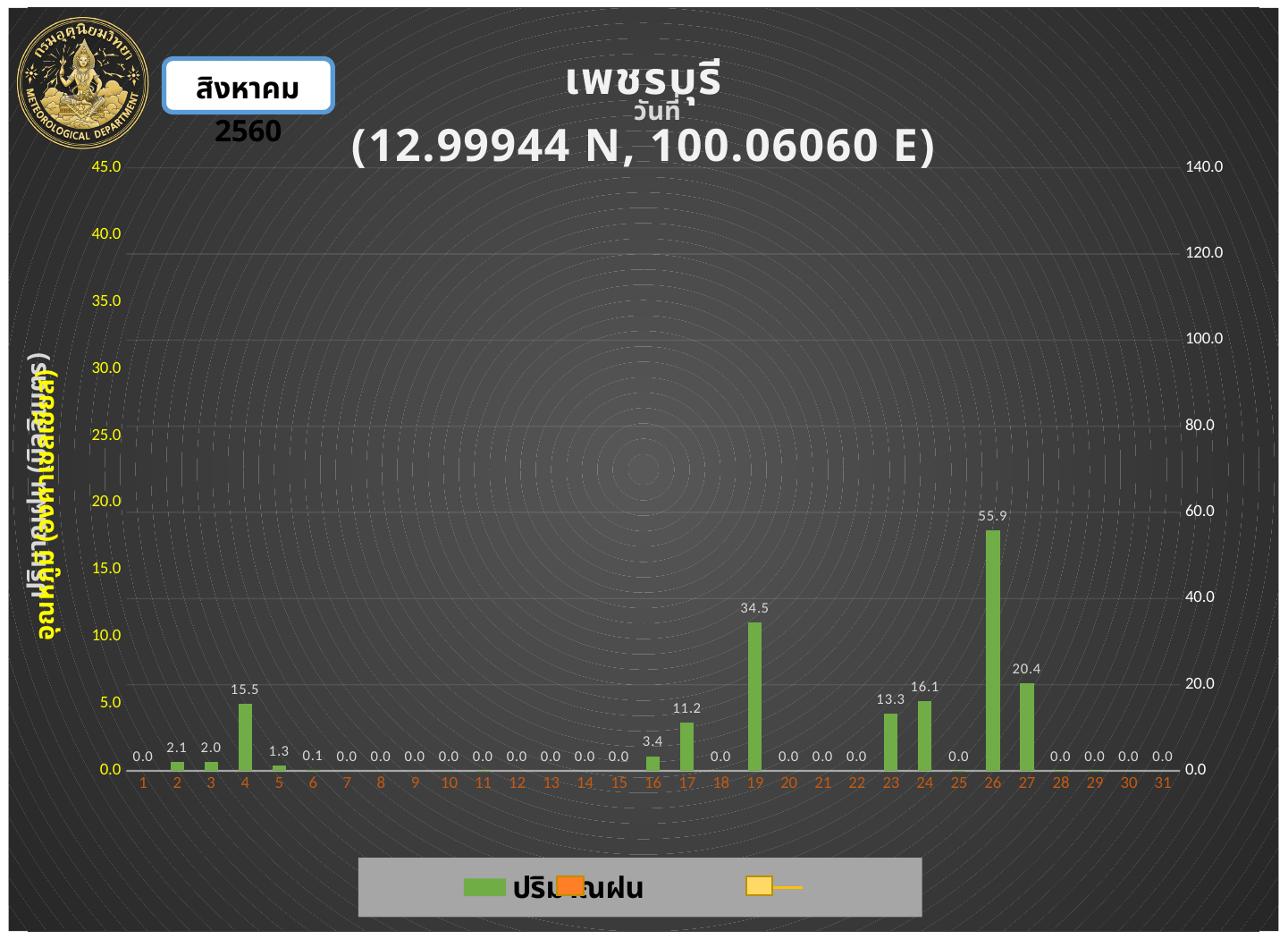
What is the rainfall value shown for day 4? 15.5 What is the rainfall value shown for day 26? 55.9 Which has the larger rainfall value, day 4 or day 24? day 24 What kind of chart is shown on the slide? bar chart Which day has the highest rainfall value? 26 What is the label of the green series in the legend? ปริมาณฝน What is the rainfall value shown for day 19? 34.5 How many days are shown on the x axis? 31 What is the difference between the rainfall values for day 26 and day 19? 21.4 Is the rainfall value for day 26 greater or less than 40.0 on the right axis? greater What is the rainfall value shown for day 17? 11.2 What is the difference between the rainfall values for day 24 and day 23? 2.8